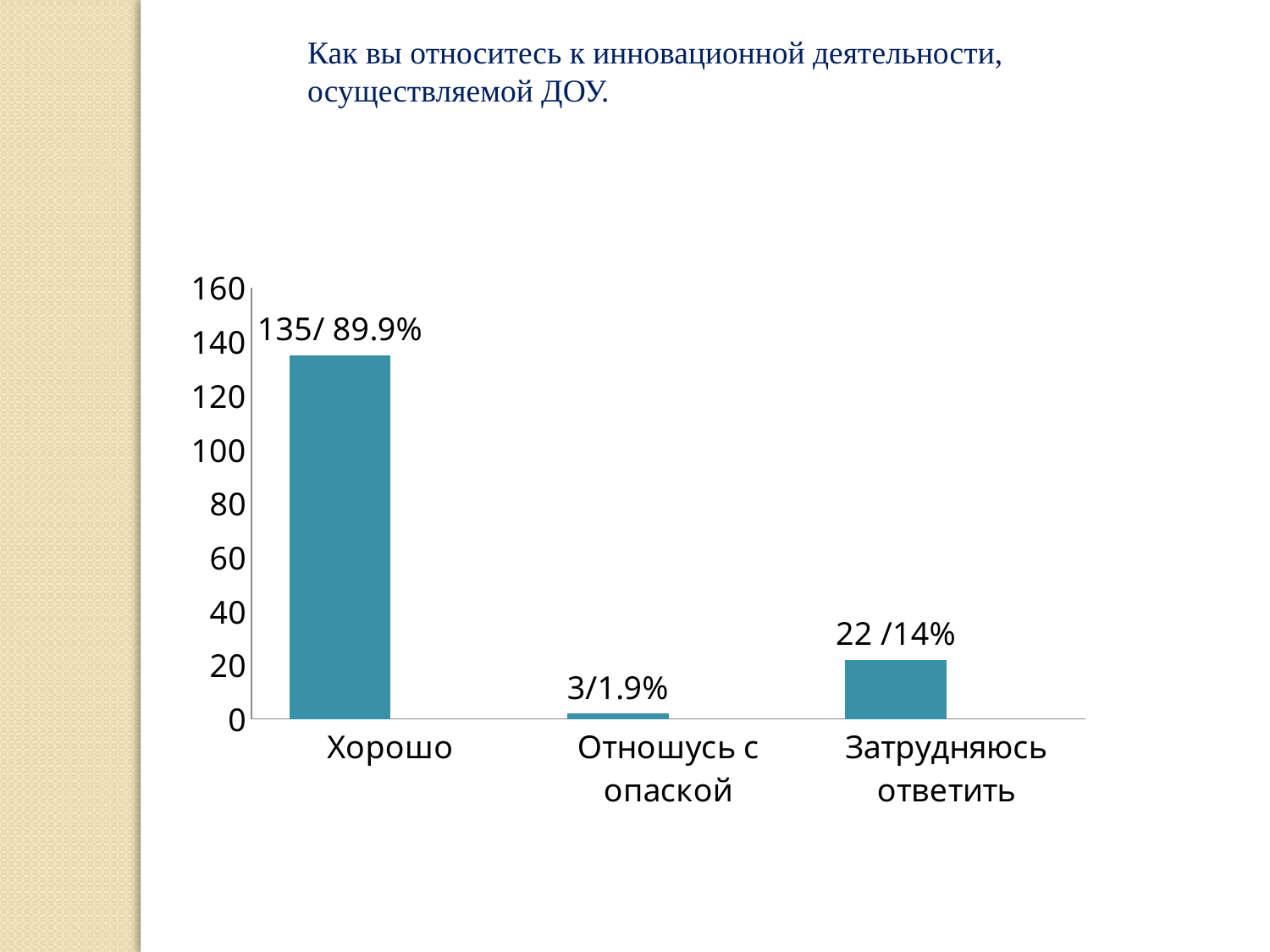
What is the difference in count between "Затрудняюсь ответить" and "Отношусь с опаской"? 19 How many categories are shown on the x axis? 3 What is the difference in count between "Хорошо" and "Затрудняюсь ответить"? 113 What is the title text above the chart? Как вы относитесь к инновационной деятельности, осуществляемой ДОУ. Which is larger, the value for "Затрудняюсь ответить" or the value for "Отношусь с опаской"? Затрудняюсь ответить What is the data label shown for the "Отношусь с опаской" bar? 3/1.9% What is the data label shown for the "Хорошо" bar? 135/ 89.9% Is the value for "Хорошо" greater or less than 120? greater What is the data label shown for the "Затрудняюсь ответить" bar? 22 /14% Which category has the lowest value? Отношусь с опаской What kind of chart is shown on the slide? bar chart Which category has the highest value? Хорошо